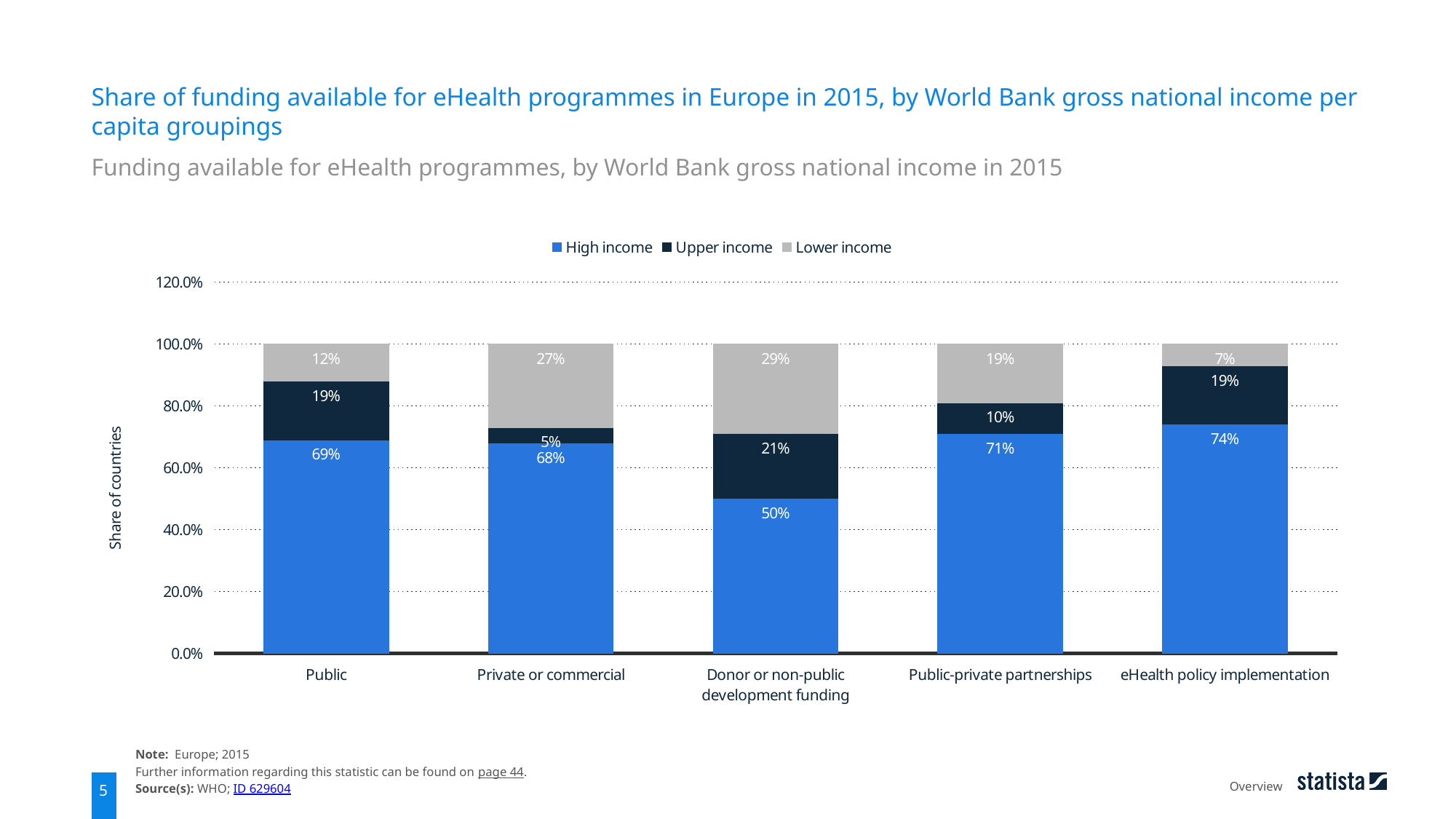
What is the High income share for Public funding? 69% What is the difference between the High income shares for eHealth policy implementation and Donor or non-public development funding? 24% Which funding category has the highest High income share? eHealth policy implementation What kind of chart is shown on the slide? Stacked bar chart What is the Upper income share for Public-private partnerships? 10% How many series does the legend list? 3 Which is larger, the Upper income share for Private or commercial or the Upper income share for Public? Public What is the Lower income share for Donor or non-public development funding? 29% How many funding categories are shown on the x axis? 5 Which funding category has the lowest High income share? Donor or non-public development funding What is the label of the y axis? Share of countries What is the Lower income share for eHealth policy implementation? 7%